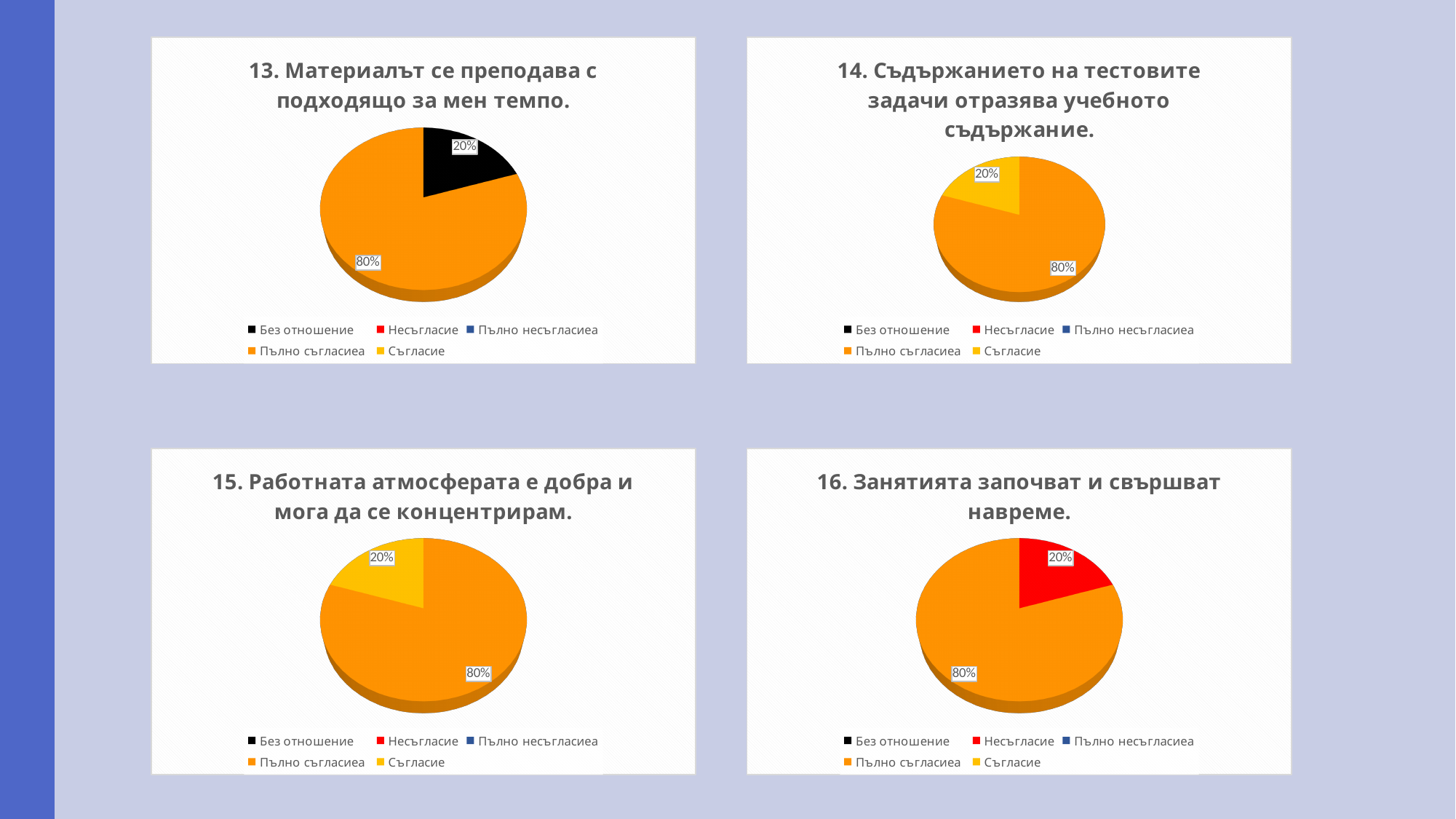
What type of chart is chart 15 ("Работната атмосферата е добра и мога да се концентрирам")? Pie chart In chart 16 ("Занятията започват и свършват навреме"), what is the difference between the "Пълно съгласиеа" slice and the "Несъгласие" slice? 60% In chart 14 ("Съдържанието на тестовите задачи отразява учебното съдържание"), which category has the largest slice? Пълно съгласиеа In chart 13 ("Материалът се преподава с подходящо за мен тempo"), which is larger: "Без отношение" or "Пълно съгласиеа"? Пълно съгласиеа In chart 16 ("Занятията започват и свършват навреме"), what share of the pie is "Несъгласие"? 20% In chart 14 ("Съдържанието на тестовите задачи отразява учебното съдържание"), what share of the pie is "Съгласие"? 20% In chart 16 ("Занятията започват и свършват навреме"), what colour is the "Несъгласие" slice? Red How many slices are visible in the pie of chart 14 ("Съдържанието на тестовите задачи отразява учебното съдържание")? 2 In chart 13 ("Материалът се преподава с подходящо за мен темпо"), what share of the pie is "Пълно съгласиеа"? 80% How many entries does the legend of chart 16 ("Занятията започват и свършват навреме") list? 5